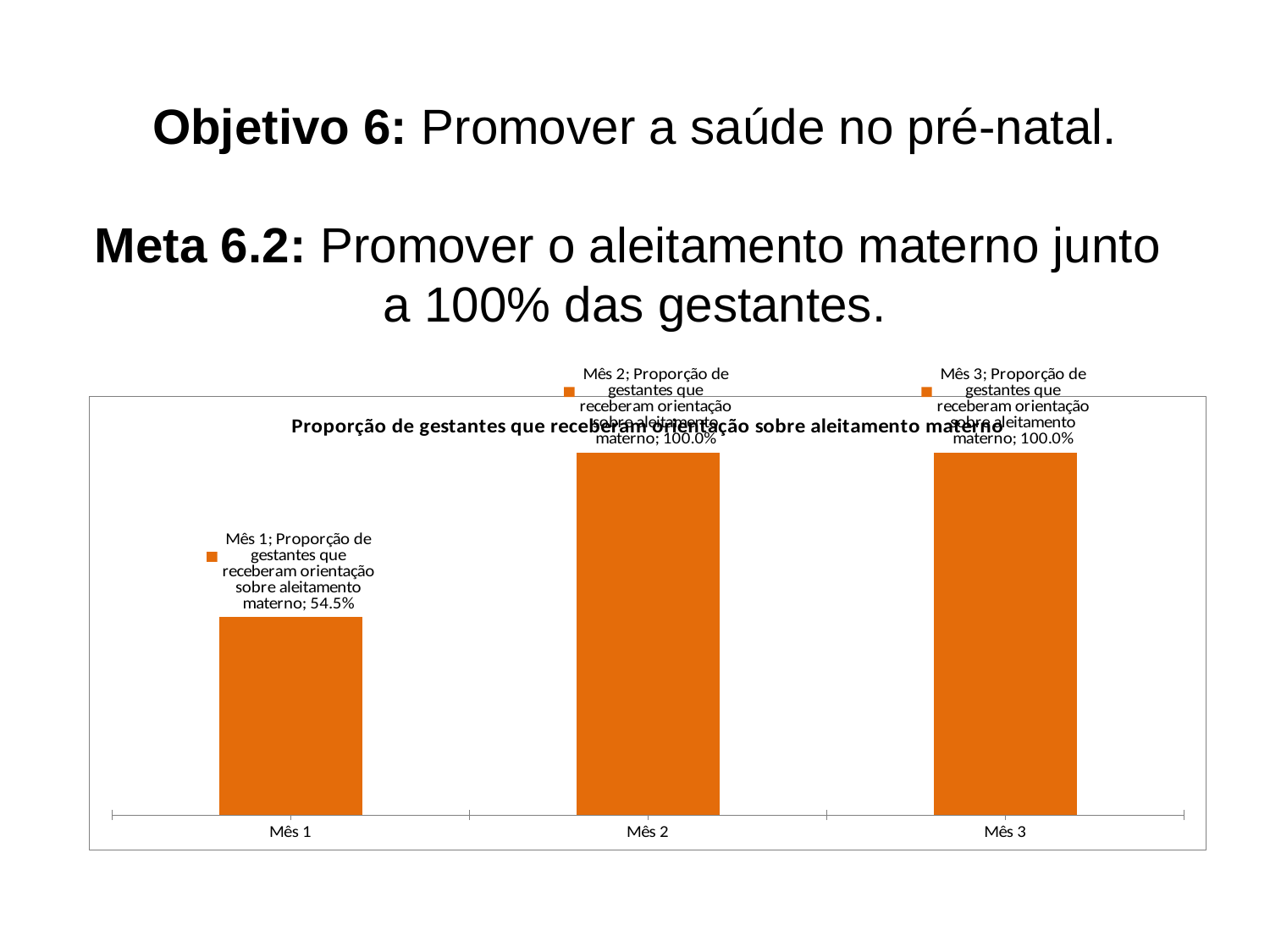
Which is larger, the value for Mês 1 or the value for Mês 3? Mês 3 Which month has the lowest proportion of pregnant women who received guidance on breastfeeding? Mês 1 What is the value for Mês 2? 100.0% What is the difference between the values for Mês 2 and Mês 1? 45.5% How many categories are shown on the x axis? 3 What is the value for Mês 1? 54.5% What is the value for Mês 3? 100.0% What is the title of the chart? Proporção de gestantes que receberam orientação sobre aleitamento materno Do the values rise or fall from Mês 1 to Mês 2? Rise What colour are the bars in the chart? Orange What kind of chart is shown on the slide? Bar chart